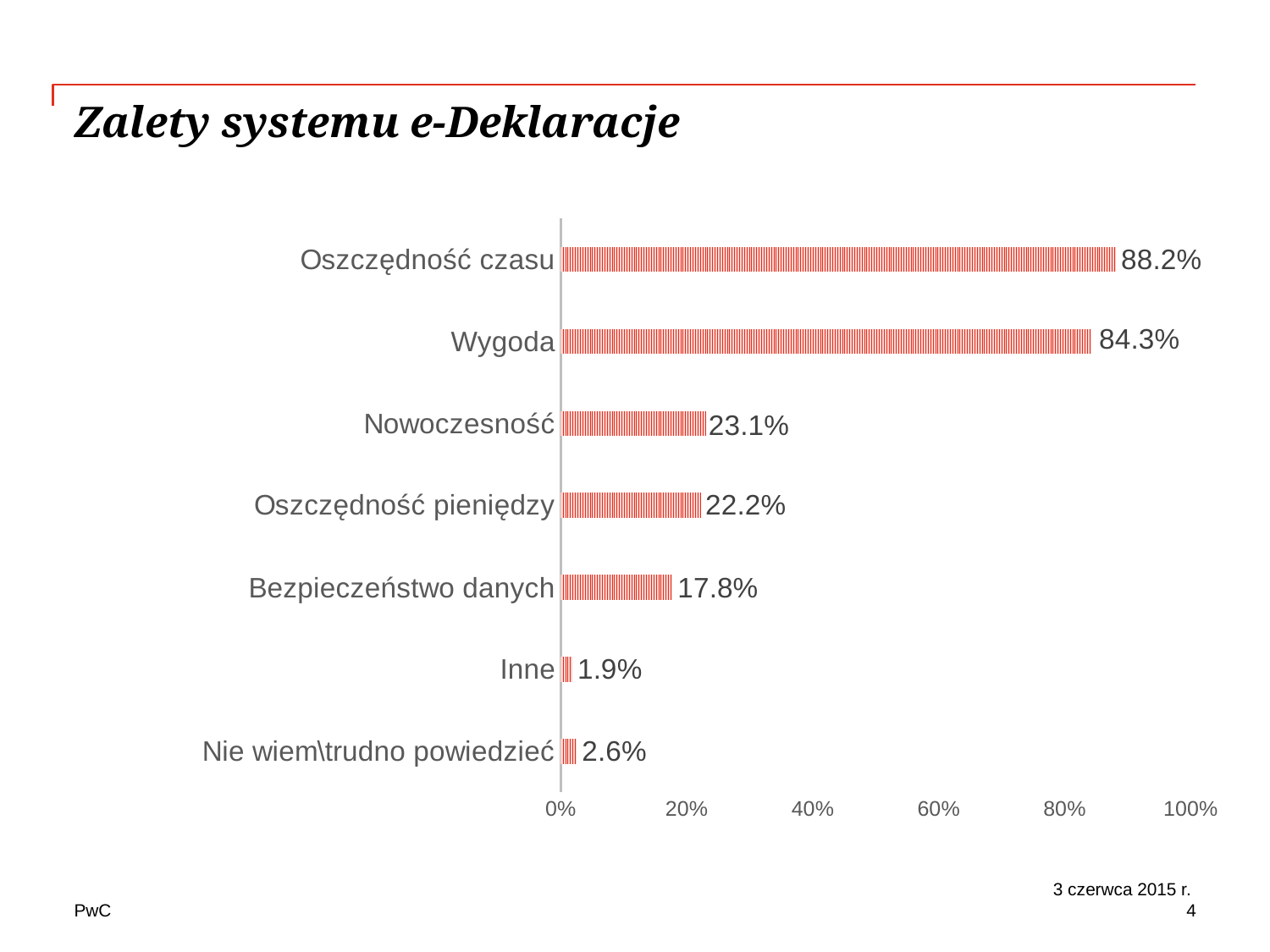
What is the value for Nie wiem\trudno powiedzieć? 2.6% What is the value for Oszczędność czasu? 88.2% What is the title of the slide? Zalety systemu e-Deklaracje Which is larger, the value for Nowoczesność or the value for Bezpieczeństwo danych? Nowoczesność What is the difference between the values for Oszczędność czasu and Wygoda? 3.9% Which category has the highest value? Oszczędność czasu What is the value for Bezpieczeństwo danych? 17.8% What is the difference between the values for Nowoczesność and Oszczędność pieniędzy? 0.9% Which category has the lowest value? Inne What is the value for Wygoda? 84.3% How many categories are shown in the chart? 7 What kind of chart is shown on the slide? bar chart